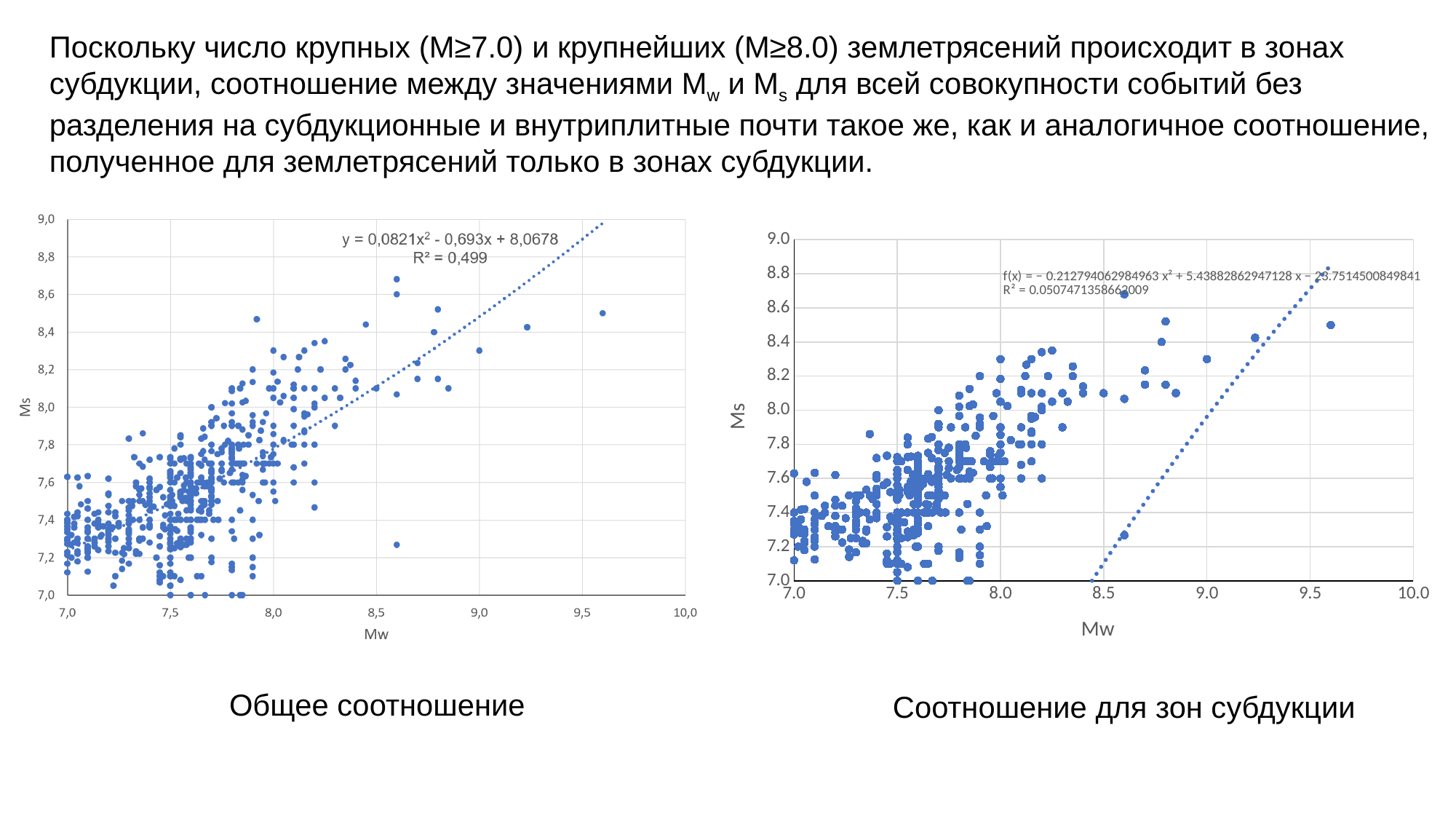
What kind of chart is the right chart titled "Соотношение для зон субдукции"? scatter chart In the left chart "Общее соотношение", what is the R² value shown for the trendline? 0,499 In the right chart "Соотношение для зон субдукции", what is the label of the y axis? Ms In the right chart "Соотношение для зон субдукции", what is the R² value shown for the trendline? 0.0507471358662009 In the right chart "Соотношение для зон субдукции", do the Ms values generally rise or fall as Mw increases? rise In the left chart "Общее соотношение", is the Ms value of the point with the largest Mw greater or less than 8,0? greater In the left chart "Общее соотношение", what is the trendline equation shown? y = 0,0821x² - 0,693x + 8,0678 In the right chart "Соотношение для зон субдукции", is the Ms value of the point with the largest Mw greater or less than 8.0? greater In the left chart "Общее соотношение", what is the label of the x axis? Mw What kind of chart is the left chart titled "Общее соотношение"? scatter chart In the left chart "Общее соотношение", do the Ms values generally rise or fall as Mw increases? rise Which chart has the higher R² value for its trendline, the left chart "Общее соотношение" or the right chart "Соотношение для зон субдукции"? Общее соотношение